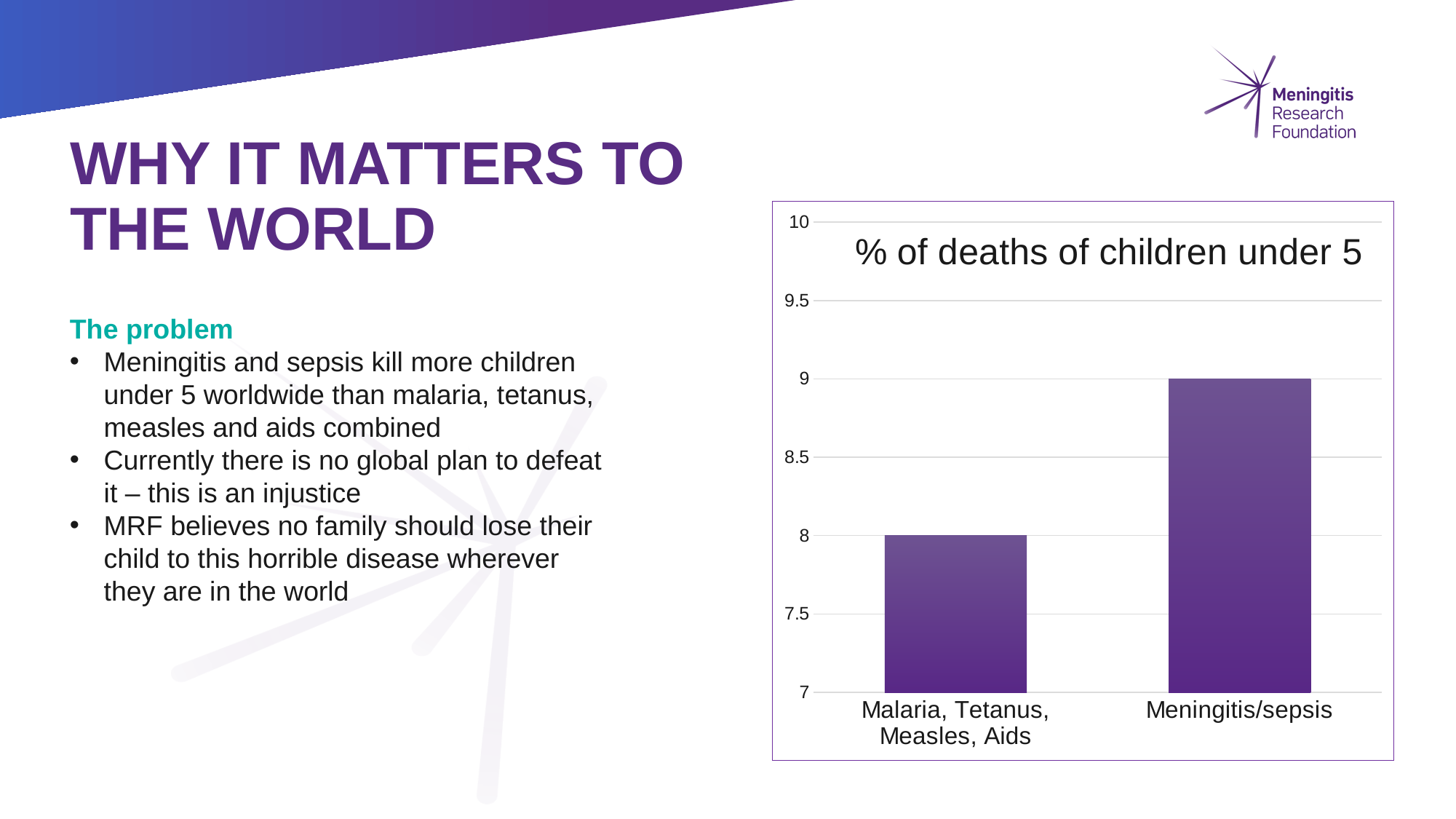
What is the value for Meningitis/sepsis in the chart? 9 Is the value for Meningitis/sepsis greater or less than 8.5? greater Which category has the lowest value in the chart? Malaria, Tetanus, Measles, Aids How many categories are plotted in the chart? 2 Which category has the highest value in the chart? Meningitis/sepsis Which is larger: the value for Meningitis/sepsis or the value for Malaria, Tetanus, Measles, Aids? Meningitis/sepsis What kind of chart is shown on the slide? bar chart What is the difference between the values for Meningitis/sepsis and Malaria, Tetanus, Measles, Aids? 1 What is the lowest value shown on the chart's vertical axis? 7 What is the title of the chart? % of deaths of children under 5 What is the value for Malaria, Tetanus, Measles, Aids in the chart? 8 Is the value for Malaria, Tetanus, Measles, Aids greater or less than 8.5? less